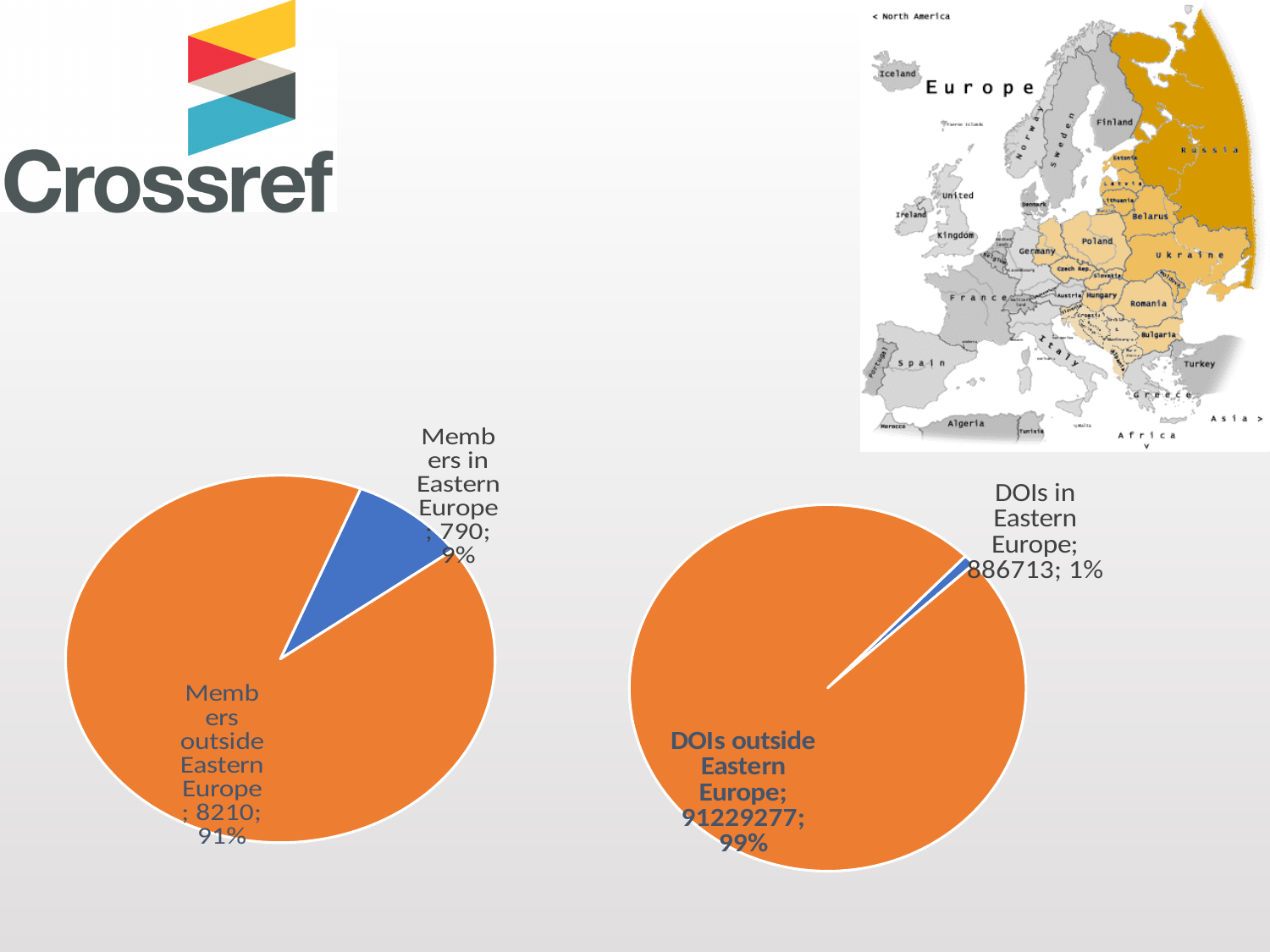
In the left pie chart, how many members are outside Eastern Europe? 8210 In the left pie chart, what share of the pie is 'Members in Eastern Europe'? 9% What kind of chart is the left chart on the slide? Pie chart In the right pie chart, what share of the pie is 'DOIs in Eastern Europe'? 1% How many slices does the right pie chart have? 2 In the right pie chart, how many DOIs are outside Eastern Europe? 91229277 In the right pie chart, which slice is the largest? DOIs outside Eastern Europe In the left pie chart, what is the difference between members outside Eastern Europe and members in Eastern Europe? 7420 In the right pie chart, how many DOIs are in Eastern Europe? 886713 In the left pie chart, what is the total number of members across both slices? 9000 In the left pie chart, what share of the pie is 'Members outside Eastern Europe'? 91% In the left pie chart, how many members are in Eastern Europe? 790